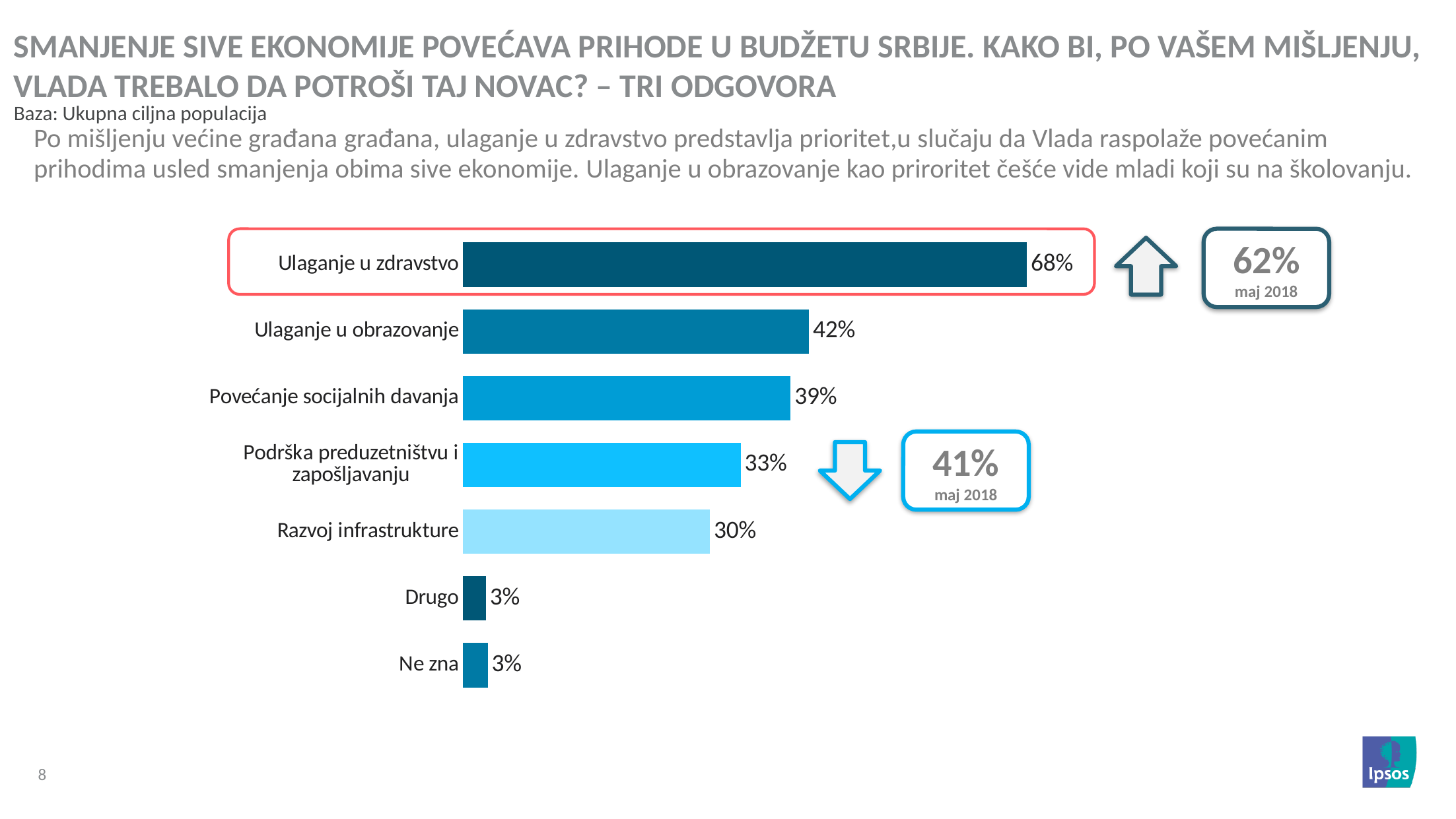
What kind of chart is shown on the slide? Bar chart What was the value for Ulaganje u zdravstvo in maj 2018, as shown in the callout box? 62% What is the difference between Povećanje socijalnih davanja and Razvoj infrastrukture? 9% What is the value for Podrška preduzetništvu i zapošljavanju? 33% Which is larger, Ulaganje u obrazovanje or Povećanje socijalnih davanja? Ulaganje u obrazovanje Which category has the highest value? Ulaganje u zdravstvo What is the difference between Ulaganje u zdravstvo and Ulaganje u obrazovanje? 26% What is the value for Ulaganje u zdravstvo? 68% What is the value for Razvoj infrastrukture? 30% What was the value shown in the callout box for maj 2018 next to Podrška preduzetništvu i zapošljavanju? 41% What is the value for Ulaganje u obrazovanje? 42% How many categories are shown in the bar chart? 7